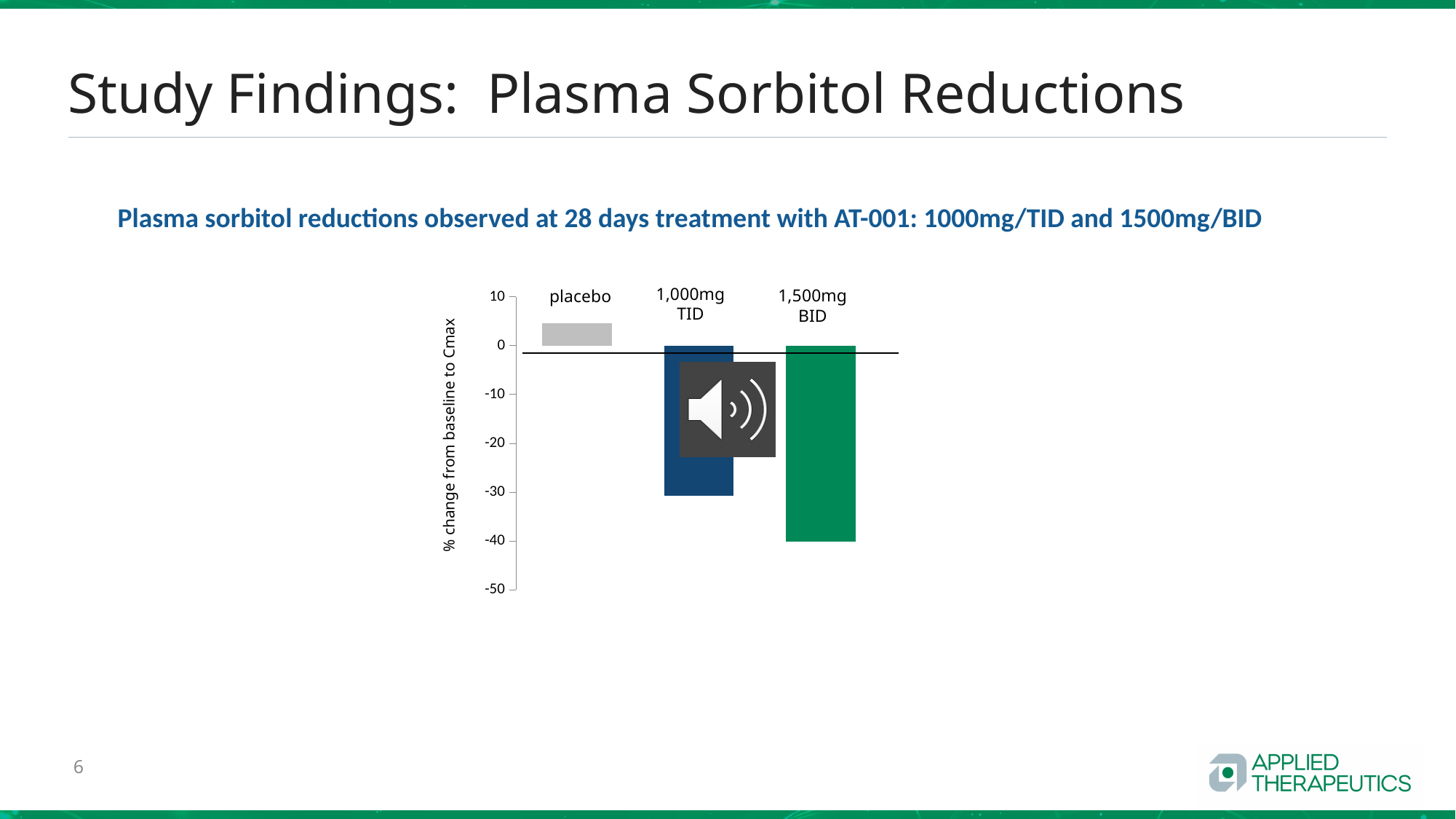
Which category shows the highest value in the chart? placebo Which category shows the lowest value (largest reduction) in the chart? 1,500mg BID Is the value for 1,000mg TID greater or less than -20? less How many categories (bars) are plotted in the chart? 3 Which has the larger value, 1,000mg TID or 1,500mg BID? 1,000mg TID Is the value for 1,500mg BID greater or less than -30? less Do the values rise or fall moving from placebo to 1,500mg BID along the x axis? fall Is the value for 1,000mg TID greater or less than -40? greater What is the label on the vertical axis of the chart? % change from baseline to Cmax Which has the larger value, placebo or 1,000mg TID? placebo What kind of chart is shown on the slide? bar chart